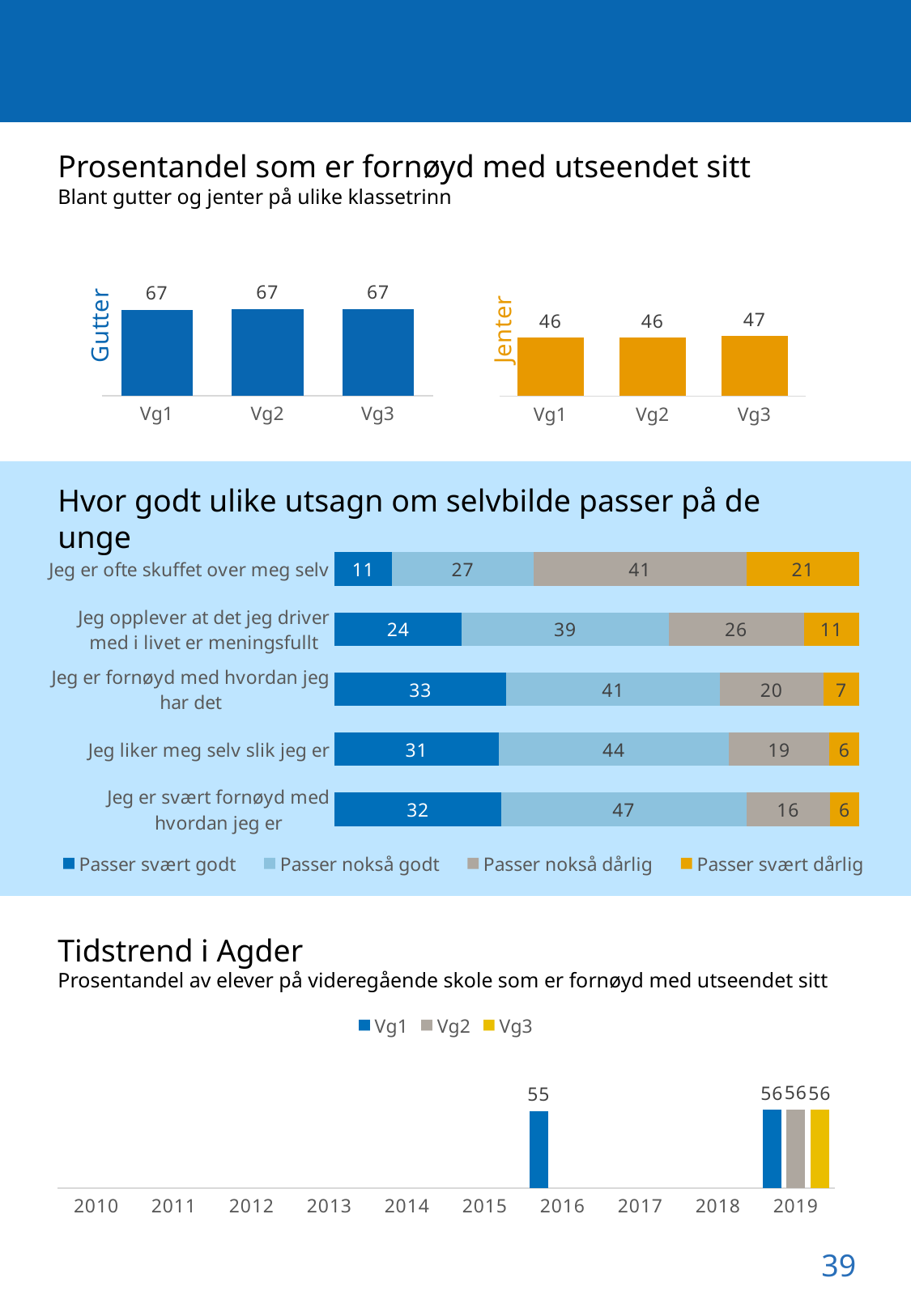
In the 'Jenter' chart, what is the value for Vg3? 47 In the 'Gutter' chart, what is the value for Vg2? 67 In the 'Hvor godt ulike utsagn om selvbilde passer på de unge' chart, how many series does the legend list? 4 In the 'Tidstrend i Agder' chart, what is the Vg1 value for 2016? 55 What kind of chart is the 'Tidstrend i Agder' chart? Bar chart In the 'Tidstrend i Agder' chart, how many years are shown on the x axis? 10 In the 'Hvor godt ulike utsagn om selvbilde passer på de unge' chart, what is the 'Passer nokså godt' value for 'Jeg er svært fornøyd med hvordan jeg er'? 47 Comparing the 'Gutter' and 'Jenter' charts, what is the difference between the Vg1 value for gutter and the Vg1 value for jenter? 21 In the 'Jenter' chart, which category has the highest value? Vg3 In the 'Hvor godt ulike utsagn om selvbilde passer på de unge' chart, which statement has the lowest 'Passer svært godt' value? Jeg er ofte skuffet over meg selv In the 'Hvor godt ulike utsagn om selvbilde passer på de unge' chart, what is the 'Passer svært dårlig' value for 'Jeg er ofte skuffet over meg selv'? 21 In the 'Hvor godt ulike utsagn om selvbilde passer på de unge' chart, what is the total of the stacked bar for 'Jeg er fornøyd med hvordan jeg har det'? 101